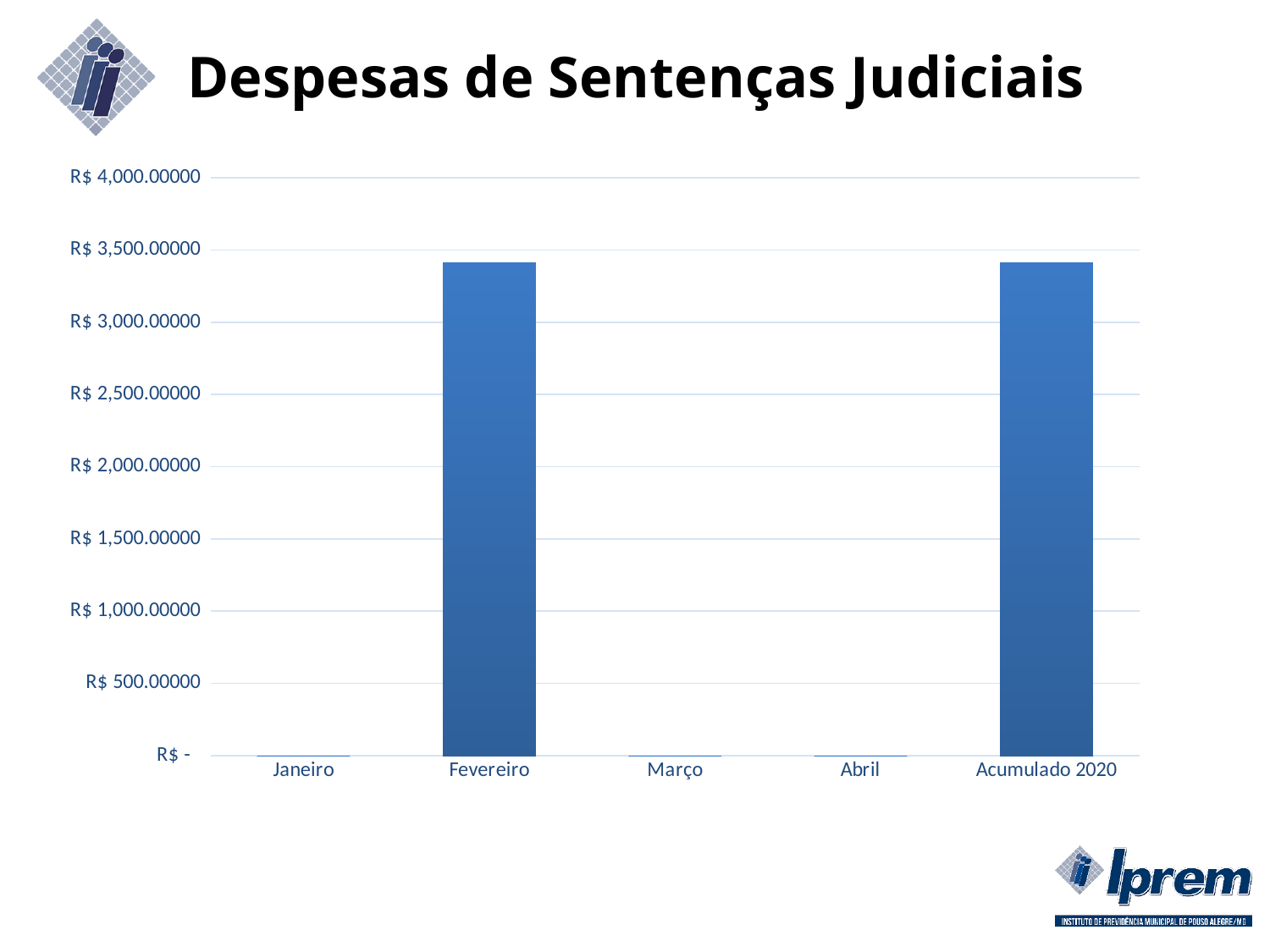
Is the value for Janeiro greater or less than R$ 500.00000? less What is the label of the last category on the x axis? Acumulado 2020 What kind of chart is shown on the slide? bar chart Which is larger, the value for Fevereiro or the value for Março? Fevereiro How many categories are shown on the x axis of the chart? 5 Is the value for Fevereiro greater or less than R$ 3,000.00000? greater What is the title of the chart on the slide? Despesas de Sentenças Judiciais Which is larger, the value for Abril or the value for Acumulado 2020? Acumulado 2020 Is the value for Acumulado 2020 greater or less than R$ 3,000.00000? greater